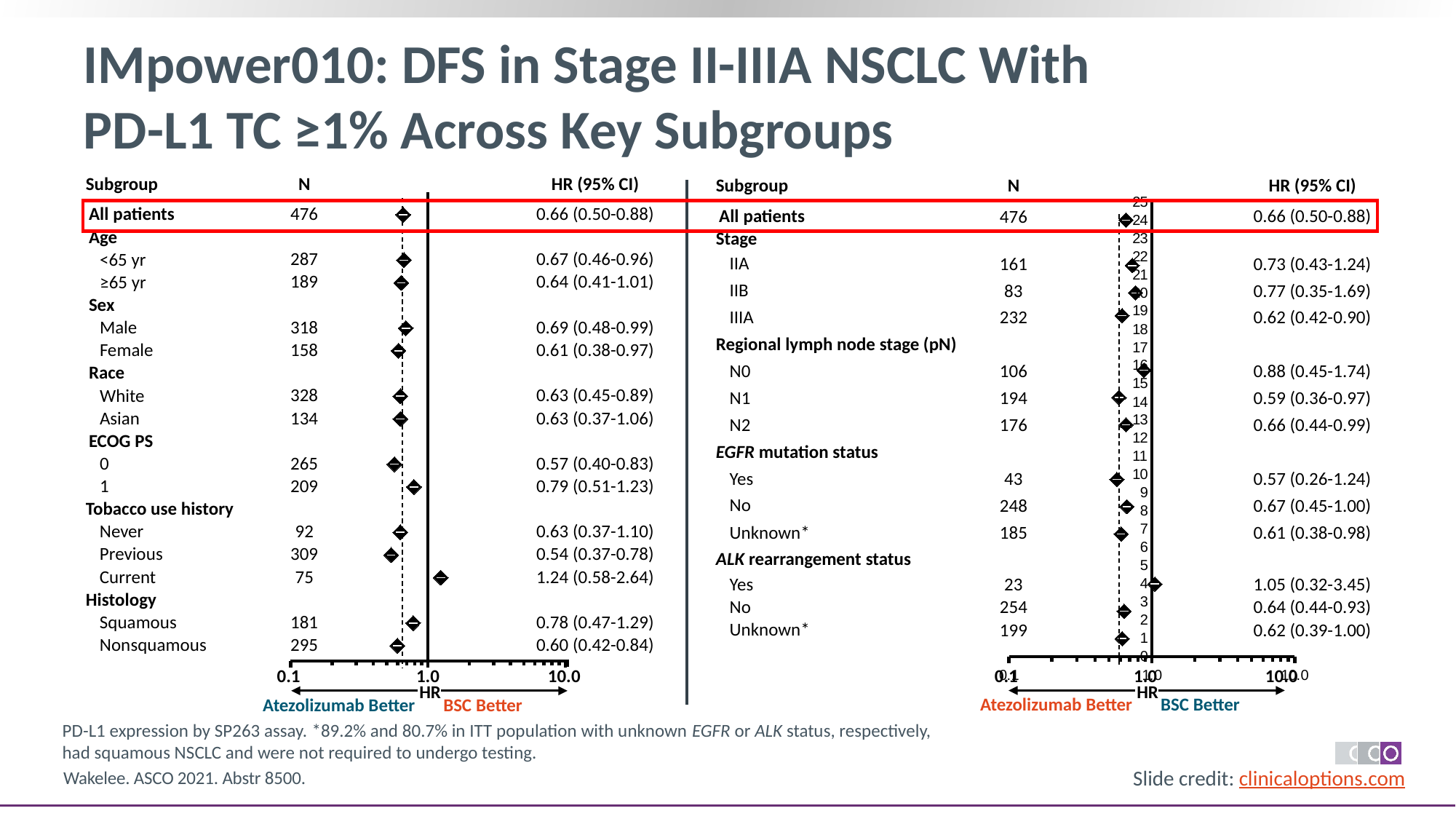
In the right forest plot, what is the HR (95% CI) for the N1 regional lymph node stage subgroup? 0.59 (0.36-0.97) In the left forest plot, is the hazard ratio for the Current tobacco use subgroup greater or less than 1.0? greater In the left forest plot, what is the N for the Current tobacco use subgroup? 75 In the left forest plot, which has the larger hazard ratio, Male or Female? Male What kind of chart is shown on the slide? Forest plot In the left forest plot, what is the difference in N between the Male and Female subgroups? 160 In the right forest plot, which subgroup has the highest hazard ratio? ALK rearrangement status Yes In the left forest plot, which subgroup has the highest hazard ratio? Current (tobacco use history) In the left forest plot, what is the HR (95% CI) for All patients? 0.66 (0.50-0.88) In the right forest plot, what is the N for the IIIA stage subgroup? 232 In the left forest plot, how many subgroups are listed under Tobacco use history? 3 In the left forest plot, which subgroup has the lowest hazard ratio? Previous (tobacco use history)